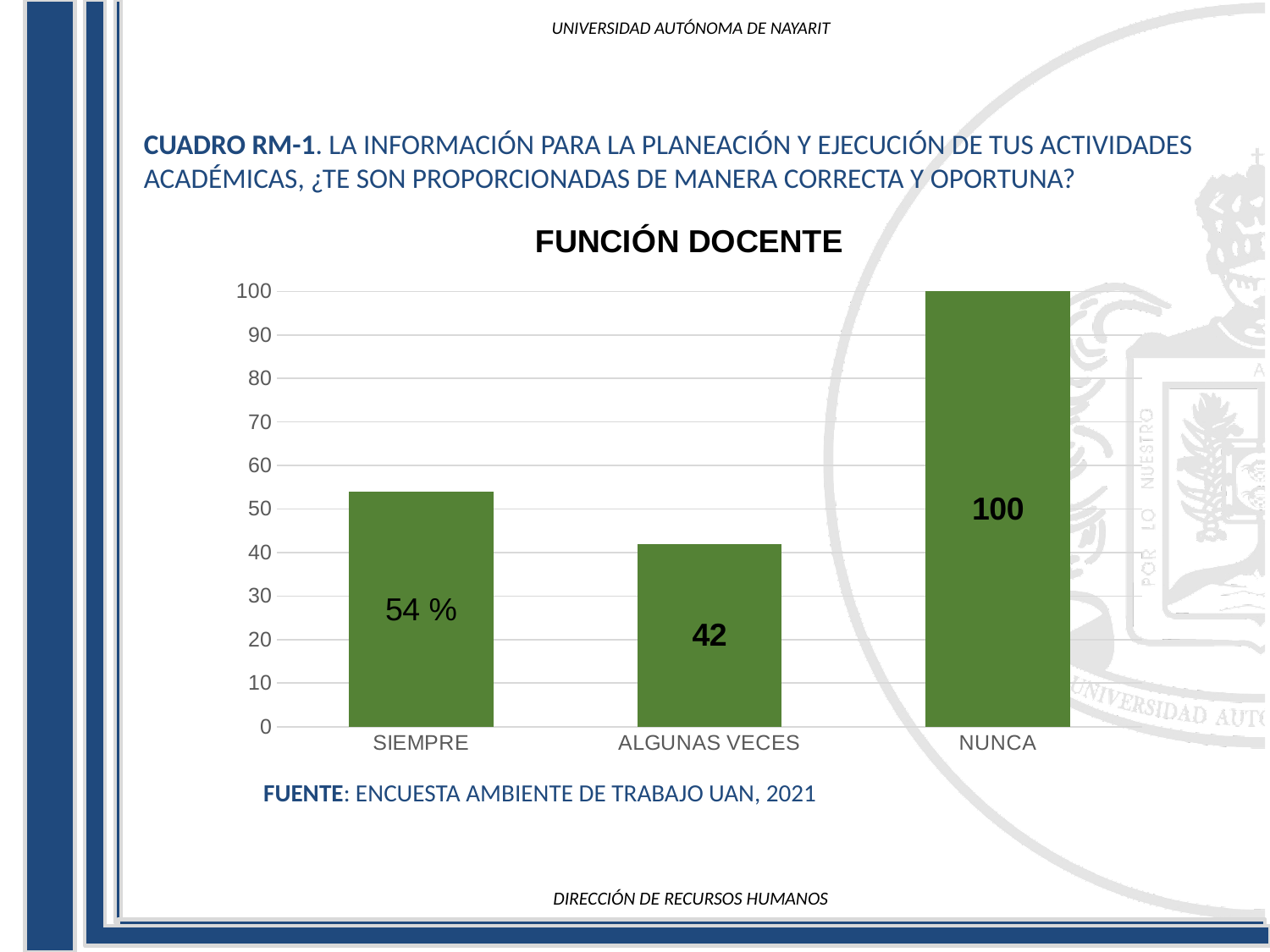
Is the value for ALGUNAS VECES greater or less than 50? less How many categories are shown on the x axis of the chart? 3 What is the value shown for NUNCA in the FUNCIÓN DOCENTE chart? 100 Which category has the lowest value in the FUNCIÓN DOCENTE chart? ALGUNAS VECES What is the title of the chart? FUNCIÓN DOCENTE What is the value shown for ALGUNAS VECES in the FUNCIÓN DOCENTE chart? 42 What is the value shown for SIEMPRE in the FUNCIÓN DOCENTE chart? 54 % What is the difference between the values for SIEMPRE and ALGUNAS VECES? 12 What is the difference between the values for NUNCA and ALGUNAS VECES? 58 What kind of chart is shown on the slide? bar chart Which category has the highest value in the FUNCIÓN DOCENTE chart? NUNCA Which is larger, the value for SIEMPRE or the value for ALGUNAS VECES? SIEMPRE